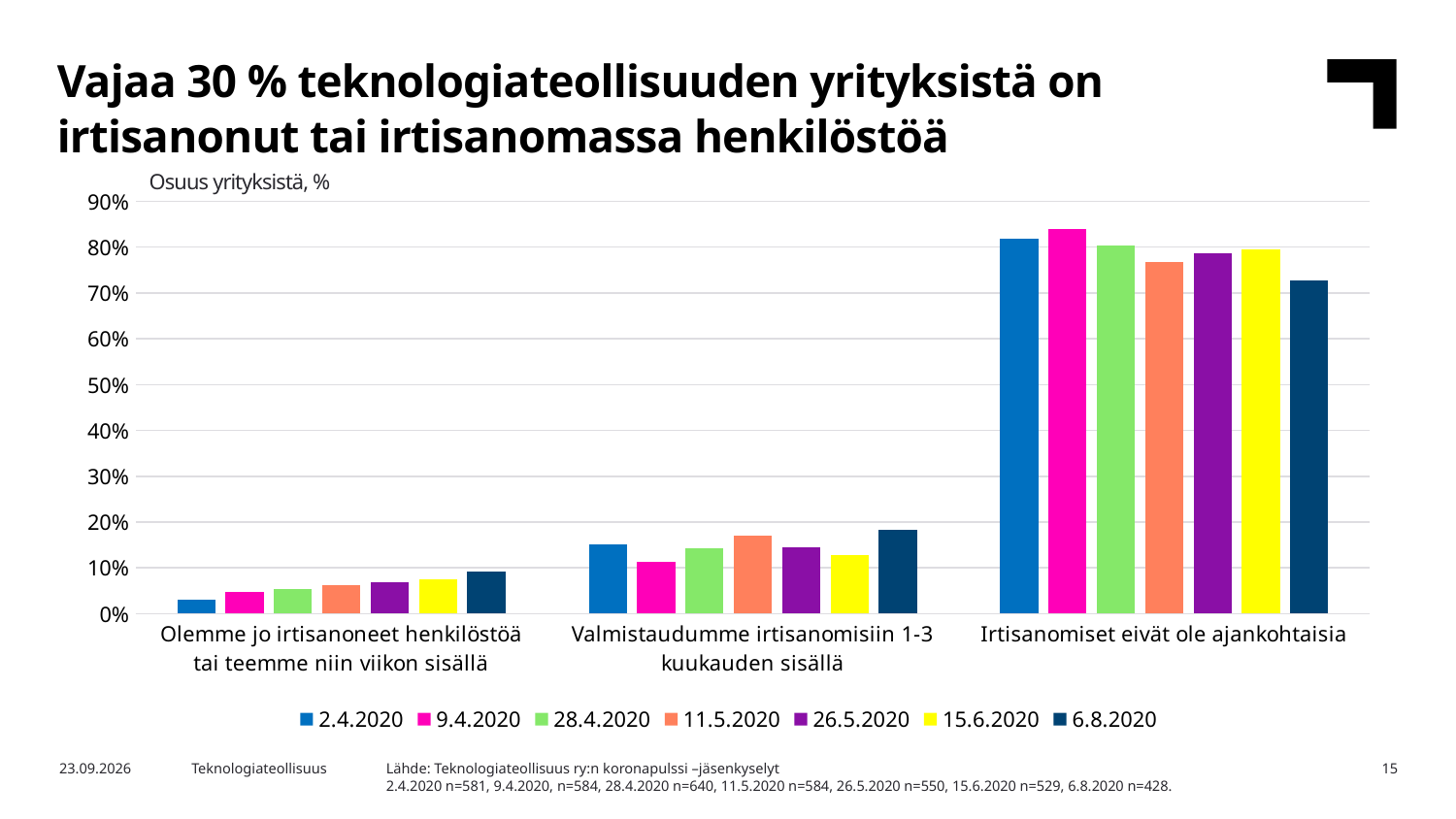
Is the value for 6.8.2020 in the category "Irtisanomiset eivät ole ajankohtaisia" greater or less than 80%? less Is the value for 6.8.2020 in the category "Valmistaudumme irtisanomisiin 1-3 kuukauden sisällä" greater or less than 10%? greater What kind of chart is shown on the slide? bar chart In the category "Irtisanomiset eivät ole ajankohtaisia", which survey date has the lowest value? 6.8.2020 In the category "Valmistaudumme irtisanomisiin 1-3 kuukauden sisällä", which is larger: the value for 11.5.2020 or the value for 9.4.2020? 11.5.2020 In the category "Olemme jo irtisanoneet henkilöstöä tai teemme niin viikon sisällä", which survey date has the lowest value? 2.4.2020 What is the label shown above the vertical axis of the chart? Osuus yrityksistä, % How many categories are shown on the x axis of the chart? 3 In the category "Olemme jo irtisanoneet henkilöstöä tai teemme niin viikon sisällä", which survey date has the highest value? 6.8.2020 In the category "Olemme jo irtisanoneet henkilöstöä tai teemme niin viikon sisällä", do the values rise or fall from 2.4.2020 to 6.8.2020? rise How many series does the chart's legend list? 7 Is the value for 6.8.2020 in the category "Olemme jo irtisanoneet henkilöstöä tai teemme niin viikon sisällä" greater or less than 10%? less